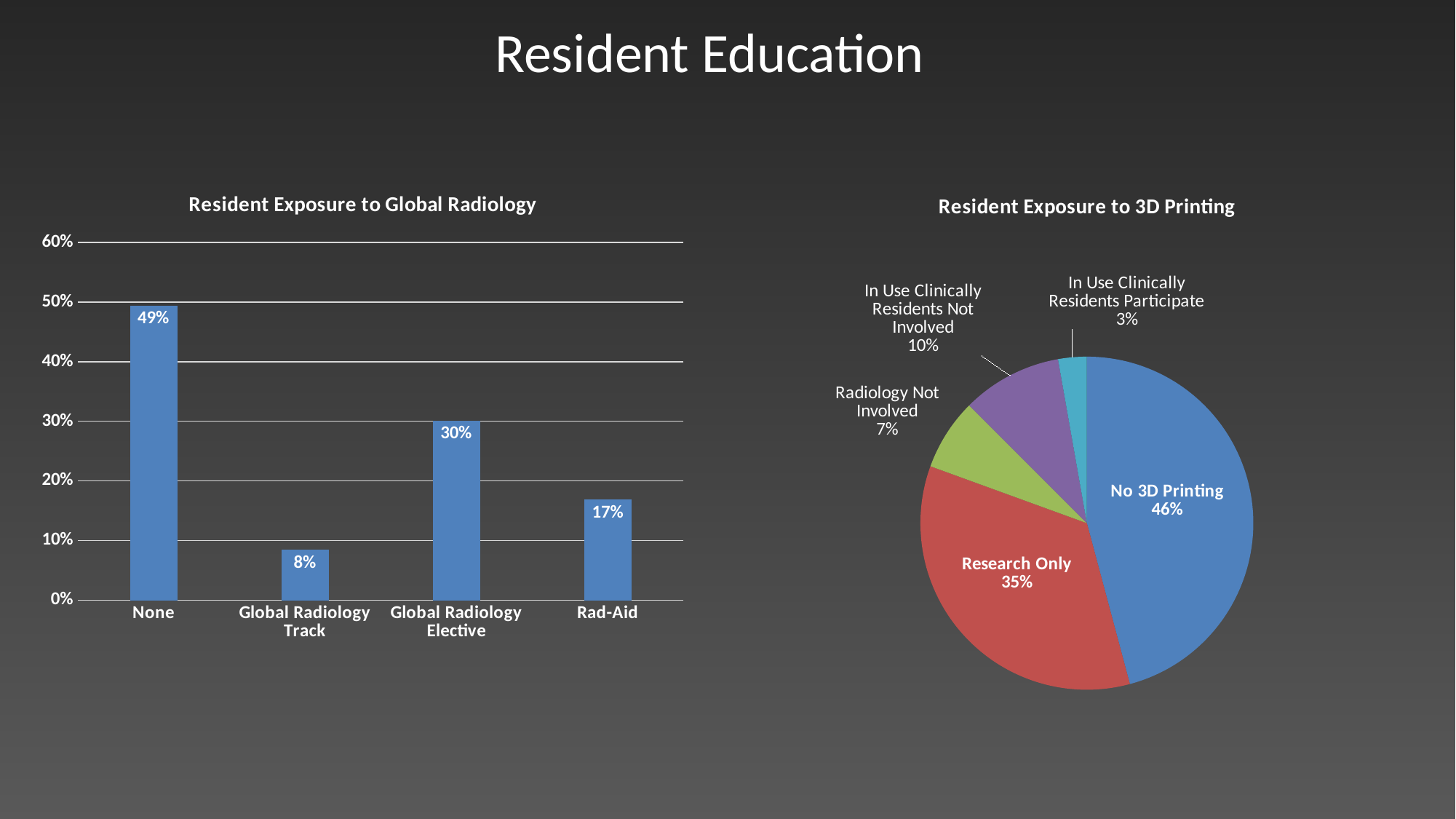
In the 'Resident Exposure to Global Radiology' chart, which category has the highest value? None In the 'Resident Exposure to Global Radiology' chart, what is the value for Rad-Aid? 17% In the 'Resident Exposure to 3D Printing' chart, which is larger: Radiology Not Involved or In Use Clinically Residents Not Involved? In Use Clinically Residents Not Involved In the 'Resident Exposure to Global Radiology' chart, which category has the lowest value? Global Radiology Track In the 'Resident Exposure to 3D Printing' chart, which slice is the smallest? In Use Clinically Residents Participate In the 'Resident Exposure to Global Radiology' chart, how many categories are shown? 4 In the 'Resident Exposure to 3D Printing' chart, how many slices are there? 5 In the 'Resident Exposure to 3D Printing' chart, what share does Research Only have? 35% In the 'Resident Exposure to 3D Printing' chart, which slice is the largest? No 3D Printing What kind of chart is 'Resident Exposure to Global Radiology'? Bar chart In the 'Resident Exposure to Global Radiology' chart, what is the difference between None and Global Radiology Elective? 19% In the 'Resident Exposure to Global Radiology' chart, what is the value for None? 49%